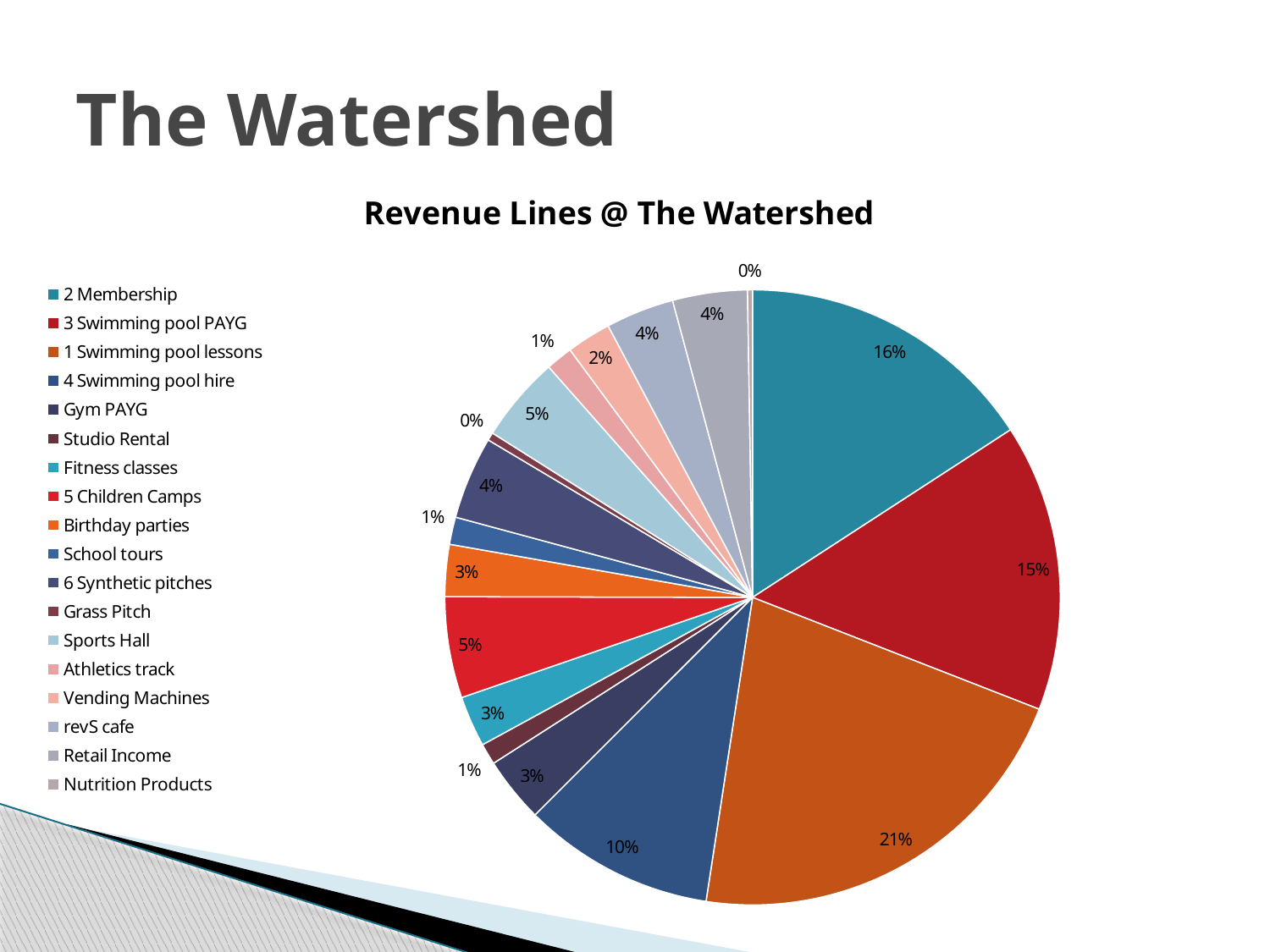
What share of revenue comes from Vending Machines? 2% Which revenue line has the largest share of the pie? 1 Swimming pool lessons Which is larger, the share for 2 Membership or the share for 3 Swimming pool PAYG? 2 Membership What type of chart is shown on the slide? pie chart What share of revenue comes from 5 Children Camps? 5% What share of revenue comes from 4 Swimming pool hire? 10% What share of revenue comes from 2 Membership? 16% What share of revenue comes from 1 Swimming pool lessons? 21% What is the difference in percentage points between the share for 1 Swimming pool lessons and the share for 2 Membership? 5 percentage points What is the title of the chart? Revenue Lines @ The Watershed What share of revenue comes from 3 Swimming pool PAYG? 15% How many revenue lines does the legend list? 18